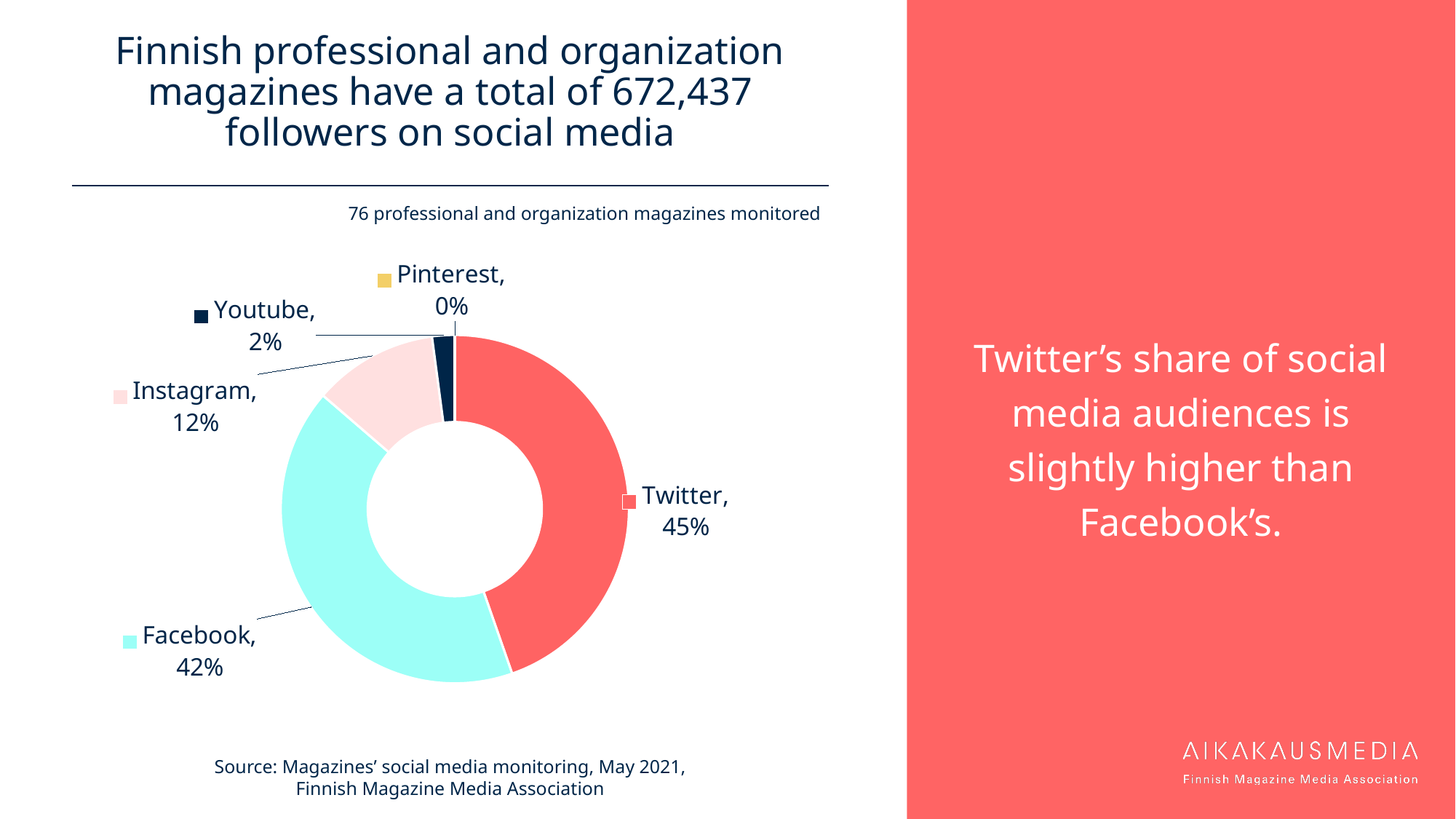
What share of social media followers does Twitter account for? 45% What kind of chart is shown on the slide? Pie chart (doughnut) Which platform has the largest share of social media followers? Twitter Which has a larger share, Instagram or Youtube? Instagram What share of social media followers does Youtube account for? 2% What share of social media followers does Instagram account for? 12% Which platform has the smallest share of social media followers? Pinterest What share of social media followers does Pinterest account for? 0% How many professional and organization magazines were monitored? 76 How many percentage points higher is Twitter's share than Facebook's? 3 How many platforms are shown in the chart? 5 What share of social media followers does Facebook account for? 42%